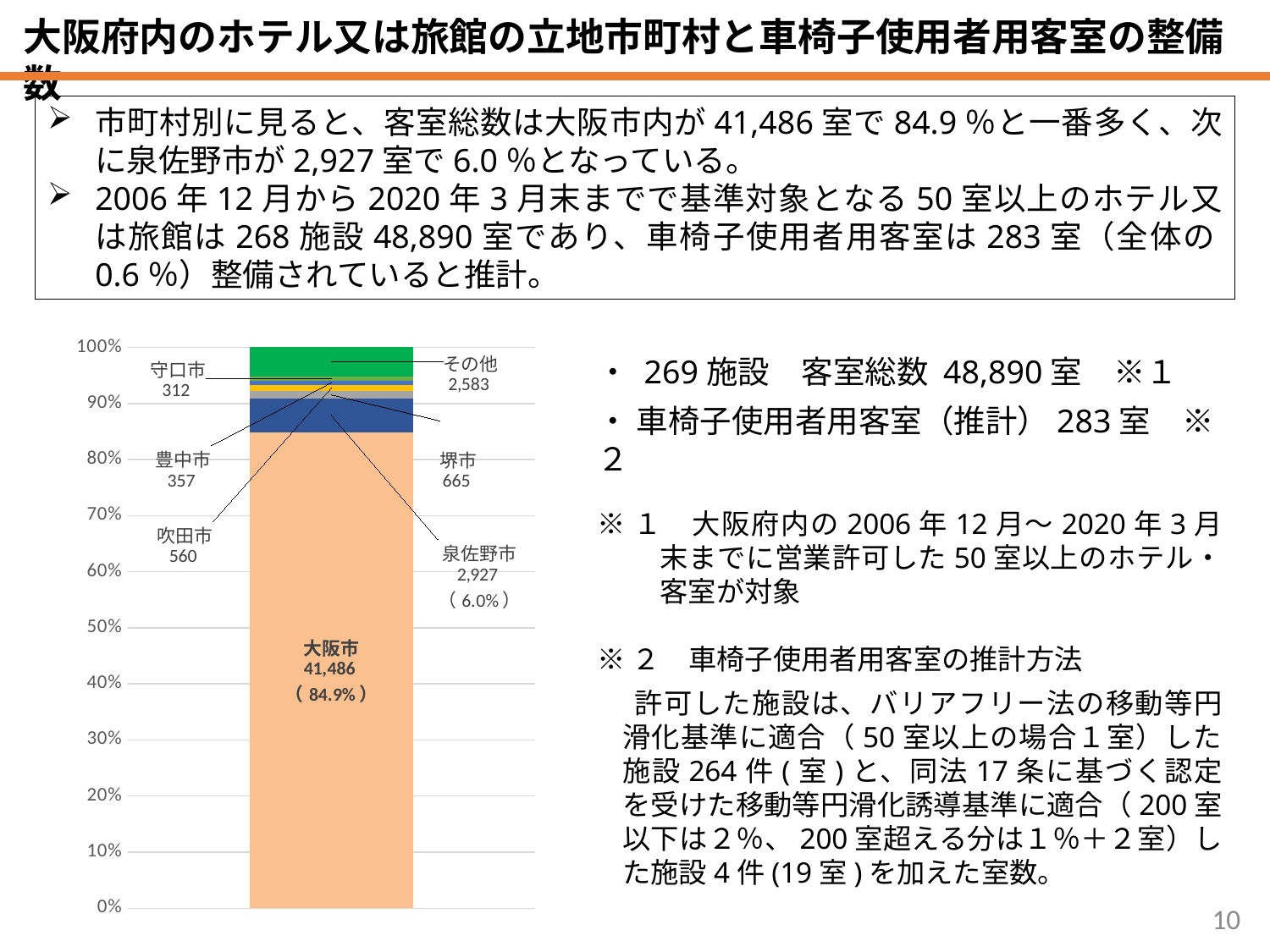
Which labelled municipality has the smallest number of rooms in the chart? 守口市 Which municipality has the largest number of rooms in the chart? 大阪市 How many rooms are labelled for 大阪市 in the chart? 41,486 What is the value labelled for 泉佐野市 in the chart? 2,927 What share of the total does 大阪市 account for according to the chart? 84.9% What is the value labelled for 堺市 in the chart? 665 What kind of chart is shown on the slide? Stacked bar chart Which has more rooms, 豊中市 or 守口市? 豊中市 What is the difference between the values for 堺市 and 吹田市? 105 What is the difference between the values for 吹田市 and 豊中市? 203 How many segments (categories) make up the stacked bar? 7 What is the value labelled for その他 in the chart? 2,583